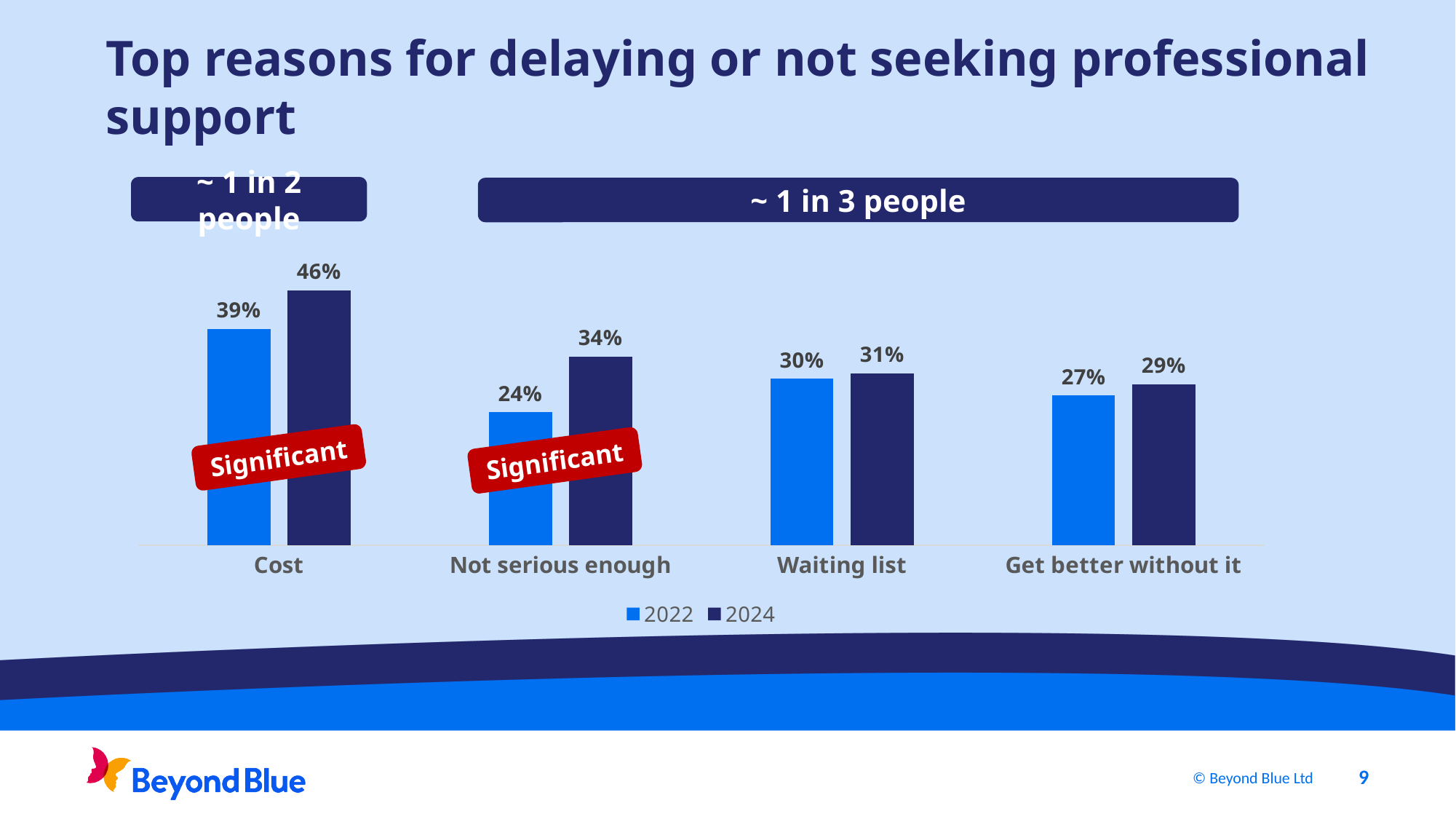
Which category has the highest 2024 value? Cost What is the difference between the 2024 and 2022 values for Not serious enough? 10% What kind of chart is shown on the slide? Bar chart What is the 2024 value for Get better without it? 29% How many categories are shown on the x axis? 4 What is the 2022 value for Waiting list? 30% How many series does the legend list? 2 What is the difference between the 2024 and 2022 values for Cost? 7% What is the 2024 value for Cost? 46% What is the 2022 value for Not serious enough? 24% Which is larger, the 2022 value for Cost or the 2024 value for Not serious enough? 2022 value for Cost Which category has the lowest 2022 value? Not serious enough